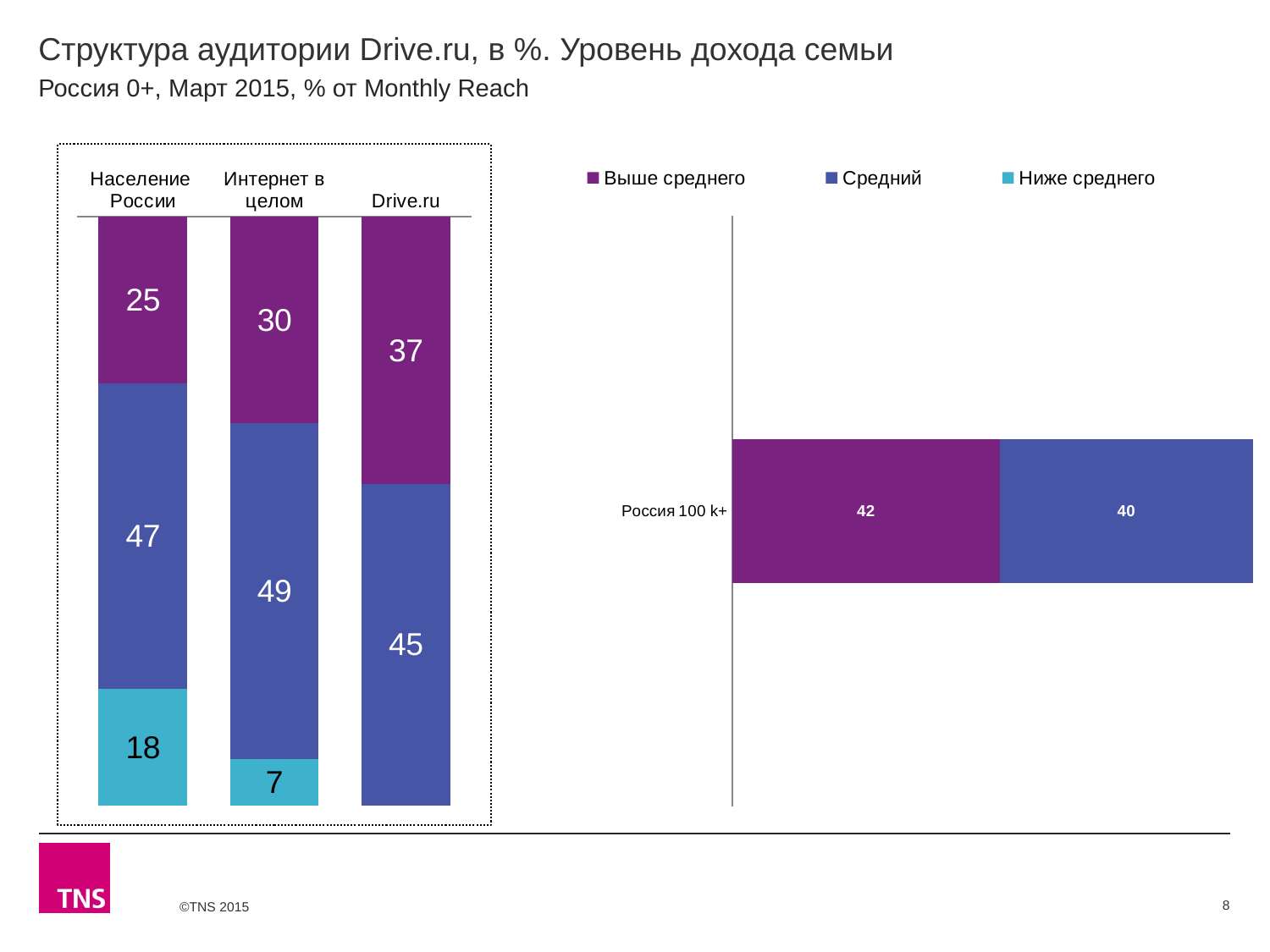
In the right chart, what is the total of the printed values for Россия 100 k+? 82 In the left chart, what is the difference between the Средний values for Интернет в целом and Население России? 2 In the left chart, which category has the lowest value for Ниже среднего among those with a printed value? Интернет в целом How many categories are shown on the x axis of the left chart? 3 In the left chart, what is the value of Выше среднего for Drive.ru? 37 What kind of chart is the right chart? Stacked bar chart In the left chart, what is the value of Средний for Интернет в целом? 49 In the left chart, which category has the highest value for Выше среднего? Drive.ru In the left chart, what is the value of Ниже среднего for Население России? 18 In the left chart, which is larger: Выше среднего for Интернет в целом or Выше среднего for Население России? Интернет в целом How many series does the legend list? 3 In the right chart, what is the value of Средний for Россия 100 k+? 40